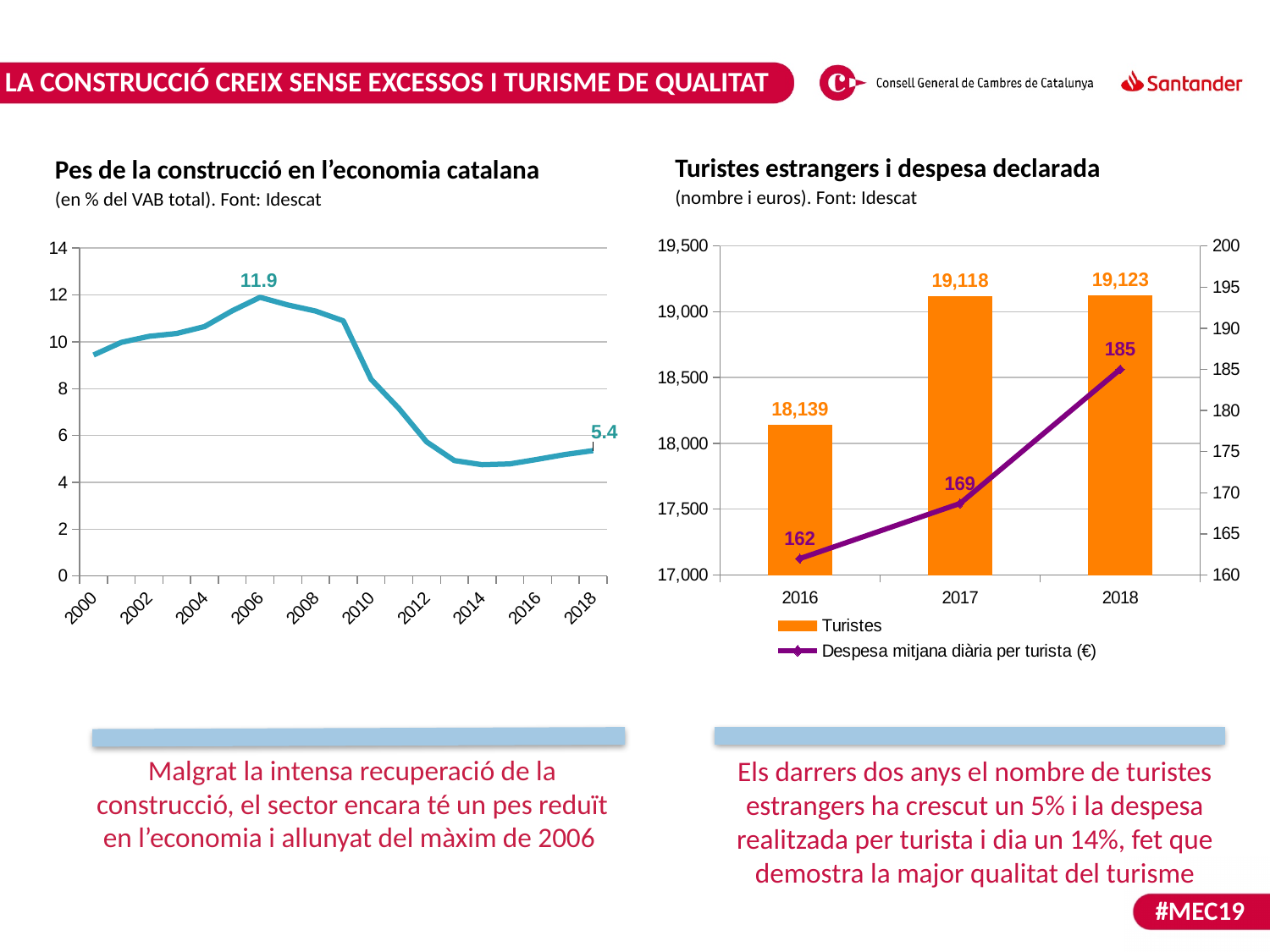
What kind of chart is 'Pes de la construcció en l'economia catalana'? line chart In the chart 'Pes de la construcció en l'economia catalana', which year has the highest value? 2006 In the chart 'Pes de la construcció en l'economia catalana', what value is labelled for 2018? 5.4 In the chart 'Turistes estrangers i despesa declarada', what is the difference in tourists between 2017 and 2016? 979 In the chart 'Turistes estrangers i despesa declarada', which year has the lowest number of tourists? 2016 In the chart 'Turistes estrangers i despesa declarada', how many series does the legend list? 2 In the chart 'Turistes estrangers i despesa declarada', how many tourists are shown for 2016? 18,139 In the chart 'Turistes estrangers i despesa declarada', what is the average daily spending per tourist in 2018? 185 In the chart 'Pes de la construcció en l'economia catalana', is the value for 2012 greater or less than 8? less In the chart 'Pes de la construcció en l'economia catalana', what is the difference between the 2006 value and the 2018 value? 6.5 In the chart 'Turistes estrangers i despesa declarada', does the average daily spending per tourist rise or fall from 2016 to 2018? rise In the chart 'Pes de la construcció en l'economia catalana', what value is labelled for 2006? 11.9